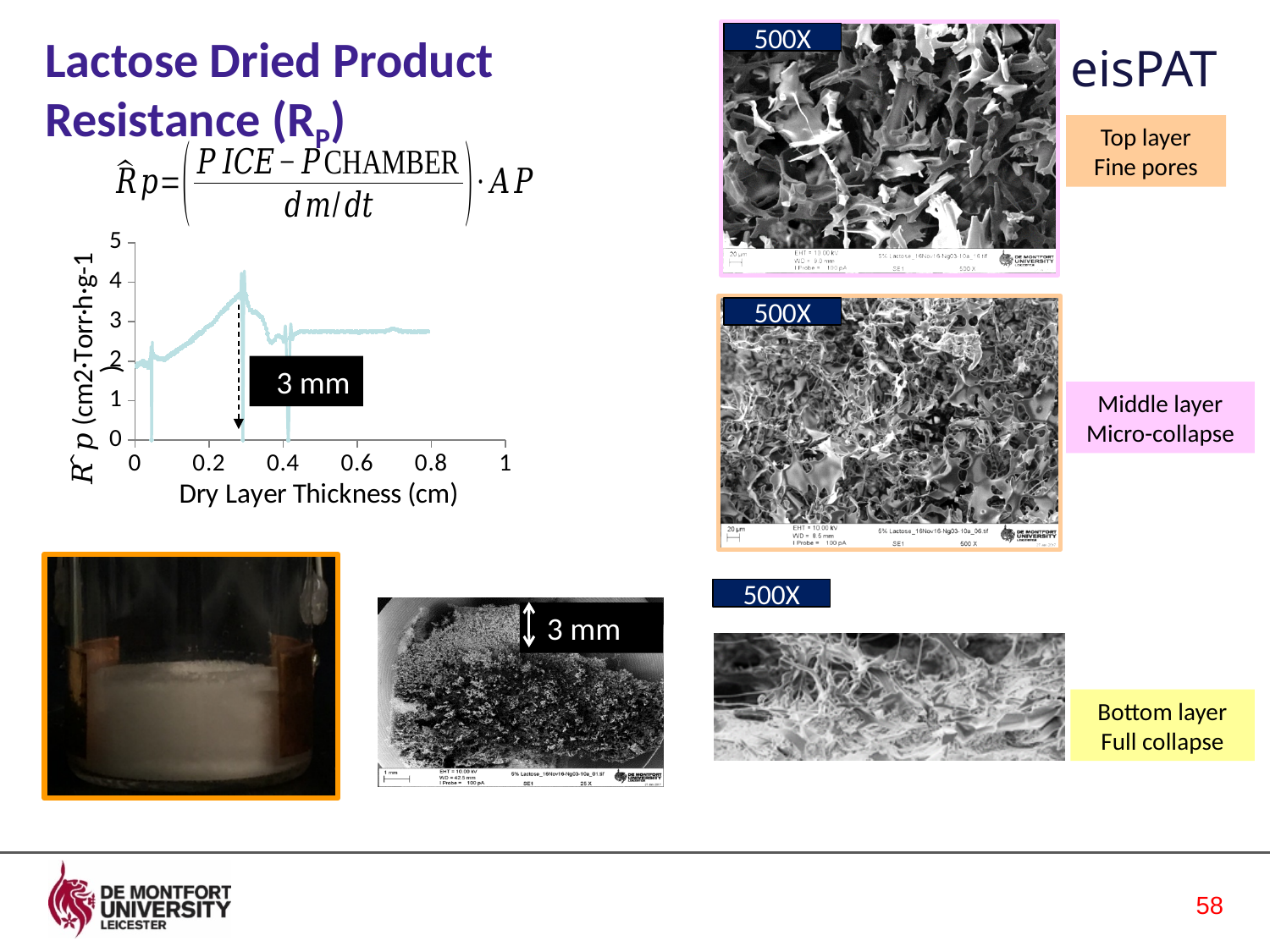
In the Rp chart, is the value at a dry layer thickness of 0.1 cm greater or less than 3? less What is the x-axis label of the Rp chart? Dry Layer Thickness (cm) In the Rp chart, is the value at a dry layer thickness of 0.8 cm greater or less than 4? less In the Rp chart, does Rp rise or fall as dry layer thickness increases from 0.1 cm to 0.3 cm? rise In the Rp chart, is the peak value of the curve greater or less than 3? greater In the Rp chart, does Rp rise or fall as dry layer thickness increases from 0.3 cm to 0.4 cm? fall What text is in the black annotation box on the Rp chart? 3 mm What is the highest tick value shown on the y-axis of the Rp chart? 5 What kind of chart is shown on the left of the slide, plotting Rp against Dry Layer Thickness? line chart